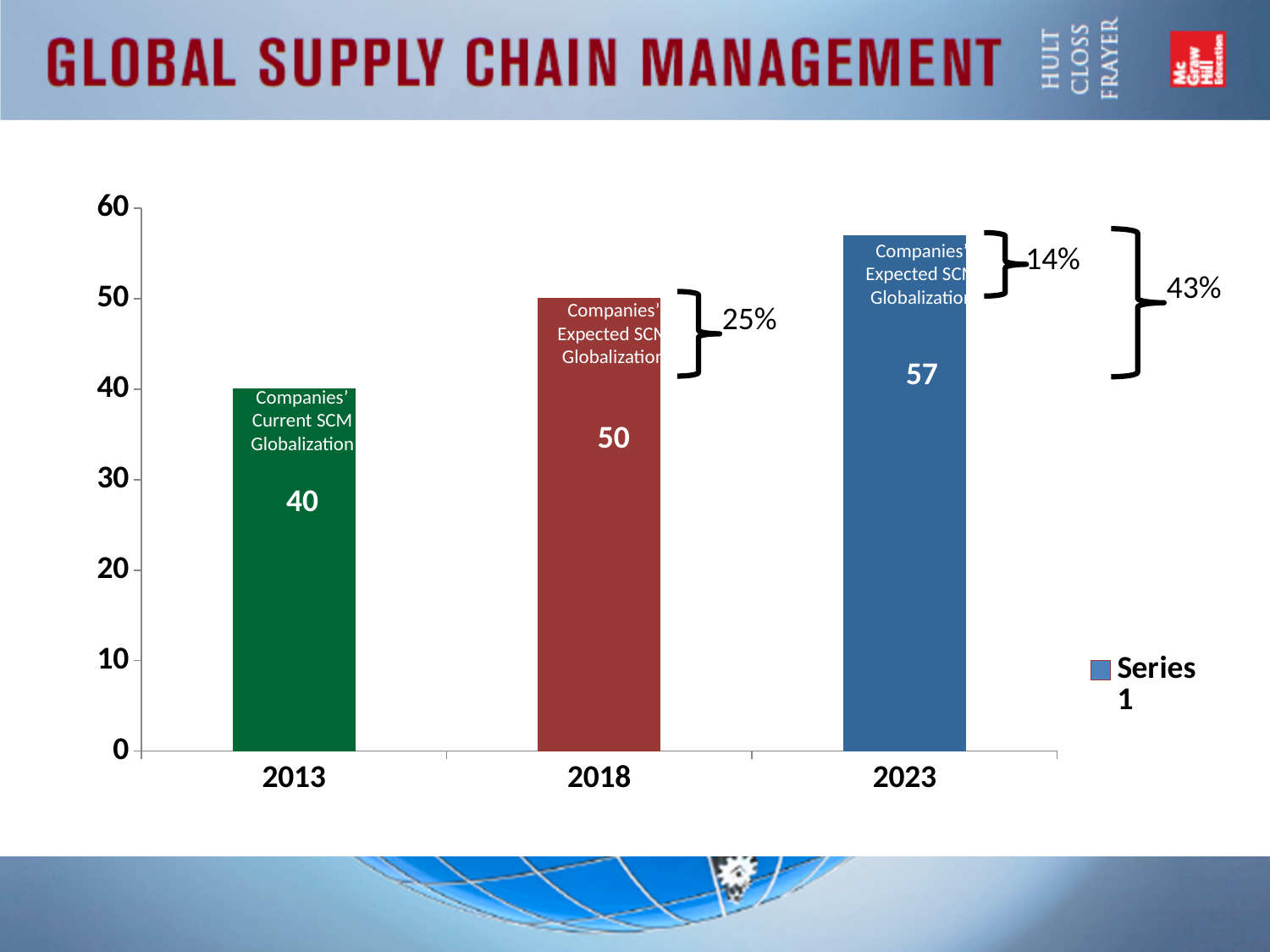
What kind of chart is this? bar chart How many years are shown on the x axis? 3 What is the difference between the values for 2018 and 2013? 10 Which is larger, the value for 2018 or the value for 2023? 2023 What is the value for 2018? 50 What is the value for 2023? 57 Do the values rise or fall from 2013 to 2023? rise What series name does the legend show? Series 1 What is the difference between the values for 2023 and 2013? 17 Which year has the highest value? 2023 Which year has the lowest value? 2013 What is the value for 2013? 40